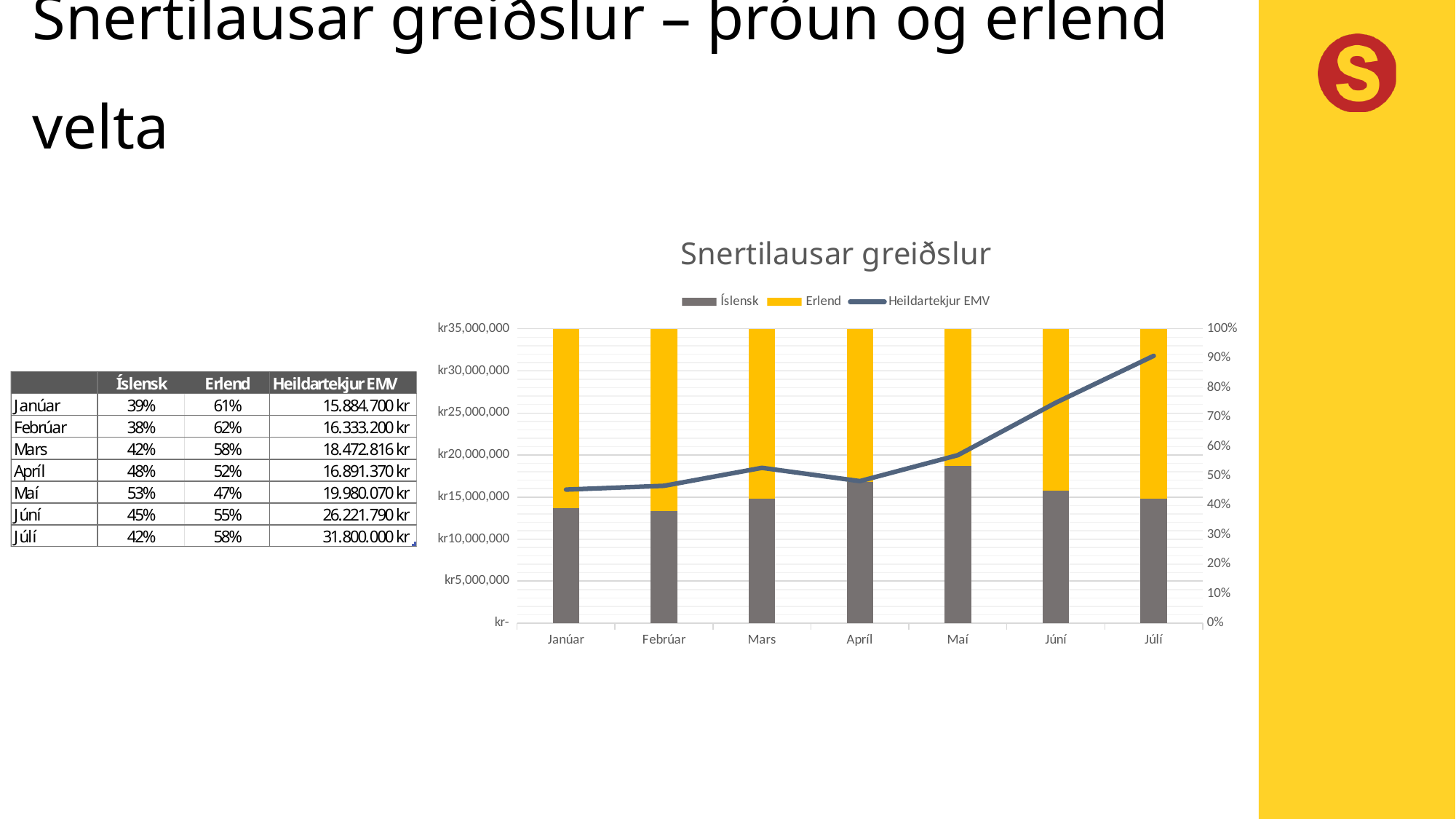
What is the difference between the Erlend and Íslensk shares in Janúar? 22 percentage points In which month is Heildartekjur EMV lowest? Janúar How many series does the legend of the "Snertilausar greiðslur" chart list? 3 What is the Erlend share in Janúar? 61% Does Heildartekjur EMV rise or fall from Apríl to Júlí? rises Is Heildartekjur EMV for Maí greater or less than kr25,000,000? less What is Heildartekjur EMV for Júlí? 31.800.000 kr In which month is Heildartekjur EMV highest? Júlí Which month has the larger Íslensk share, Apríl or Maí? Maí What is the Íslensk share in Maí? 53% How many months are shown on the x axis of the "Snertilausar greiðslur" chart? 7 What kind of chart is "Snertilausar greiðslur"? Stacked bar chart with a line